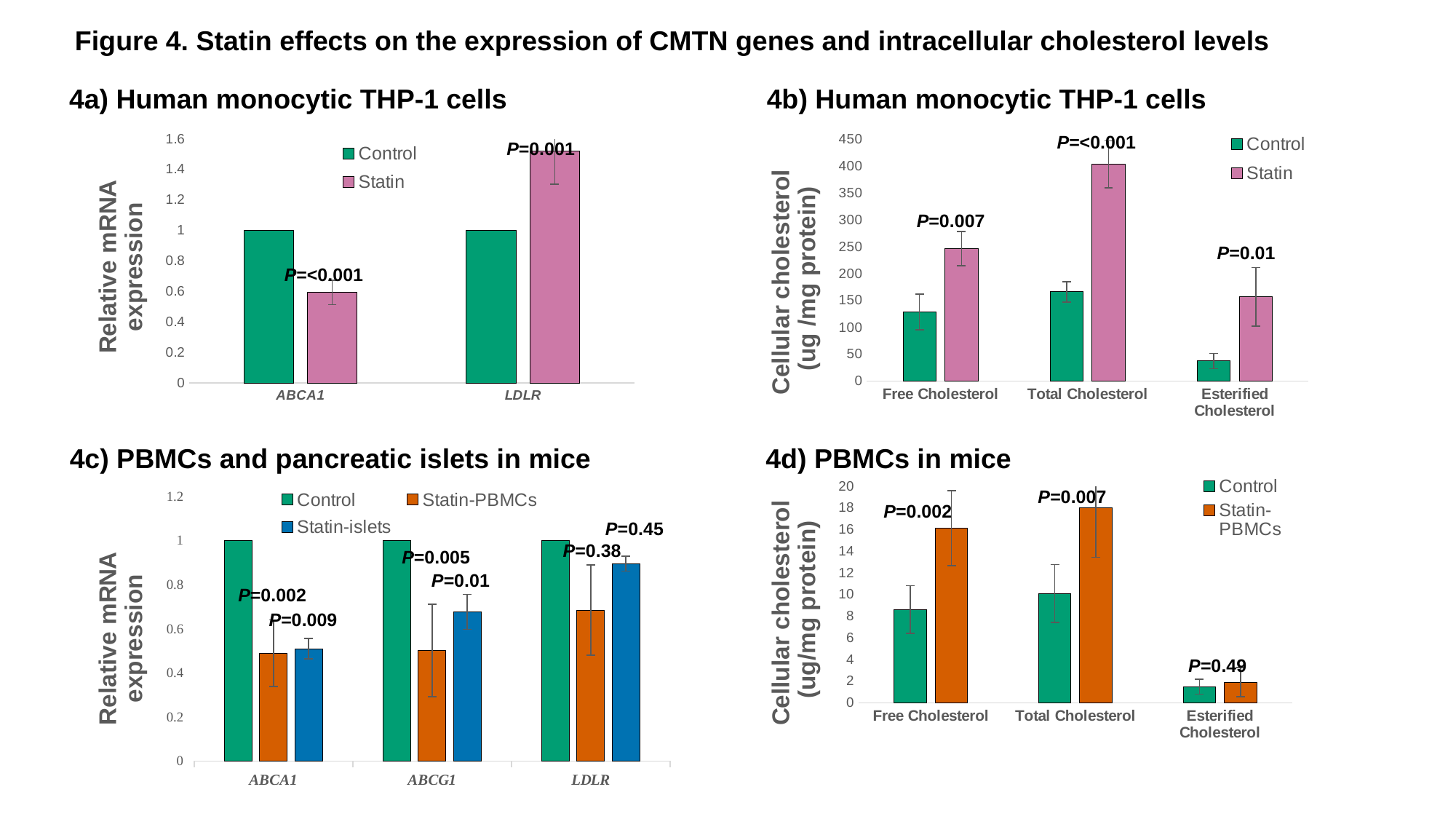
In chart 4b (Human monocytic THP-1 cells), how many categories are shown on the x axis? 3 In chart 4a (Human monocytic THP-1 cells), is the Statin value for LDLR greater or less than 1.4? greater In chart 4a (Human monocytic THP-1 cells), is the Statin value for ABCA1 greater or less than 0.8? less In chart 4c (PBMCs and pancreatic islets in mice), how many series does the legend list? 3 In chart 4d (PBMCs in mice), is the Statin-PBMCs value for Total Cholesterol greater or less than 16? greater In chart 4a (Human monocytic THP-1 cells), what is the relative mRNA expression value for Control in the ABCA1 category? 1 What kind of chart is chart 4d (PBMCs in mice)? bar chart In chart 4b (Human monocytic THP-1 cells), which bar is the highest? Statin, Total Cholesterol In chart 4a (Human monocytic THP-1 cells), how many series does the legend list? 2 In chart 4b (Human monocytic THP-1 cells), which is larger for Free Cholesterol, Control or Statin? Statin